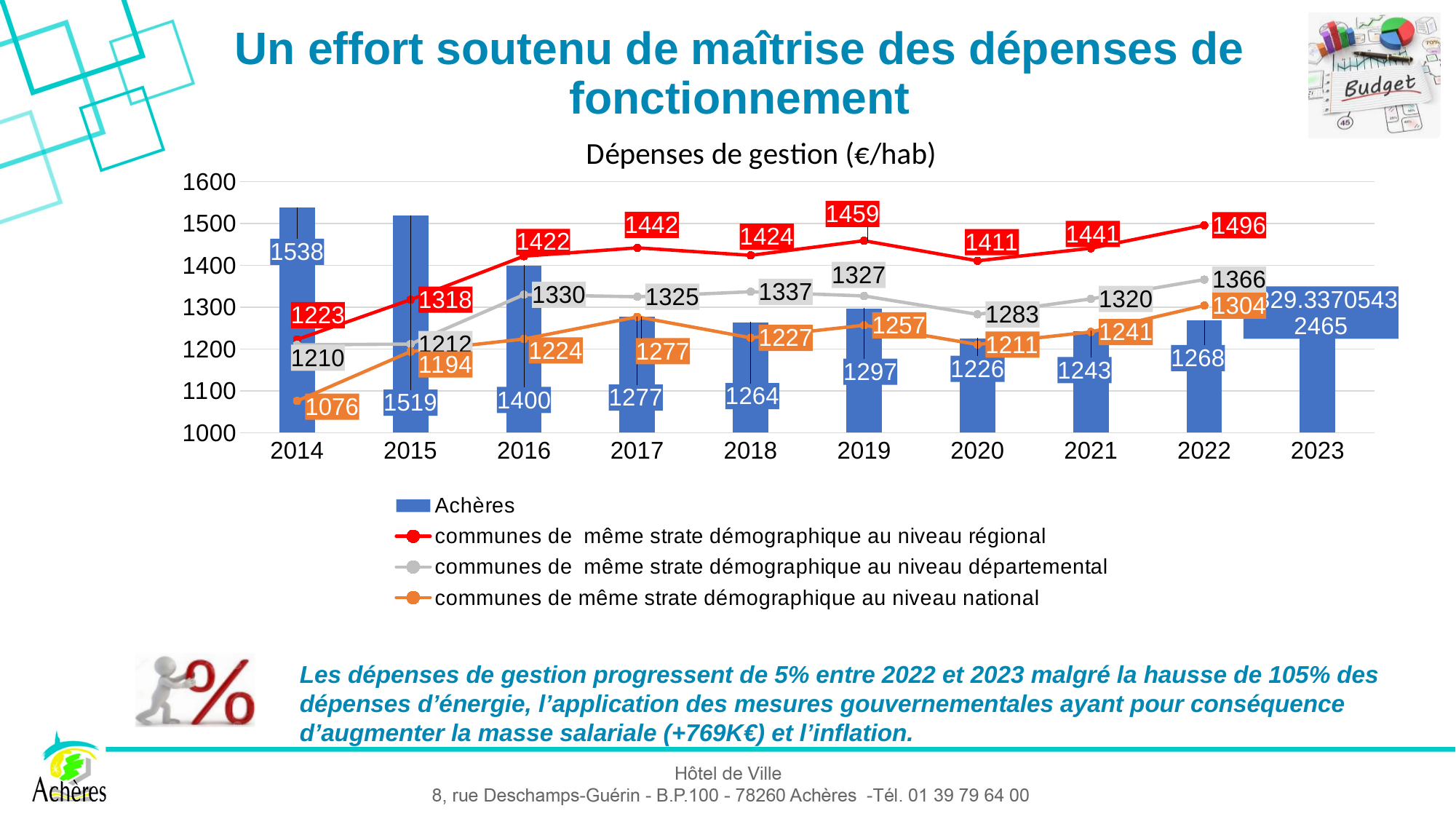
What is the value for 'communes de même strate démographique au niveau départemental' in 2019? 1327 What is the difference between the Achères value in 2014 and in 2022? 270 How many series does the legend list? 4 Which is larger in 2016: the Achères bar or the 'niveau régional' line value? niveau régional (1422) In which year is the Achères bar the lowest? 2020 In which year is the value for 'communes de même strate démographique au niveau régional' the highest? 2022 What is the value for 'communes de même strate démographique au niveau national' in 2014? 1076 What is the value for 'communes de même strate démographique au niveau régional' in 2022? 1496 What is the title of the chart? Dépenses de gestion (€/hab) What is the value of the Achères bar for 2014? 1538 How many years are shown on the x axis? 10 Is the Achères value for 2023 greater or less than 1400? less